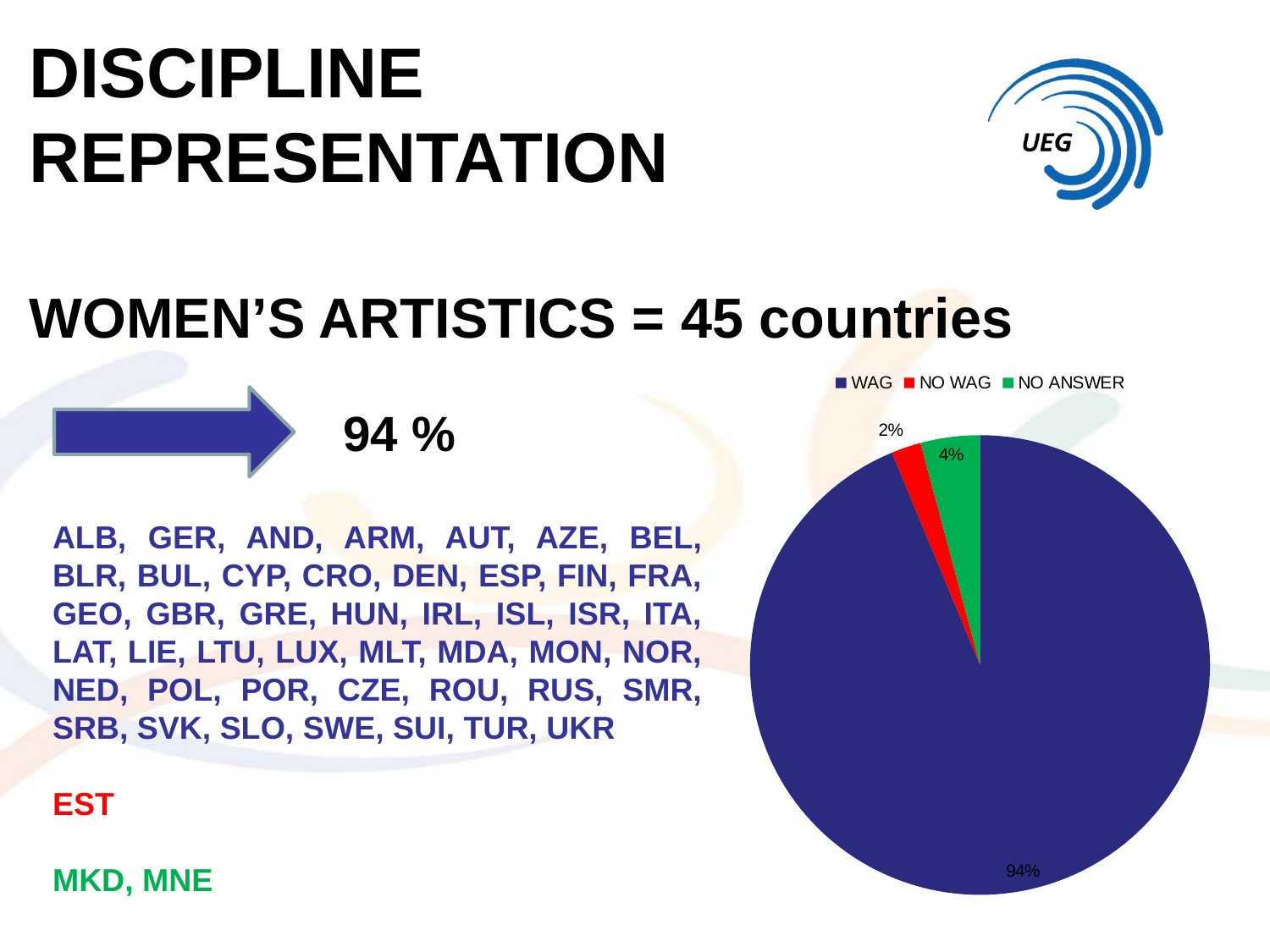
What share of the pie does NO ANSWER represent? 4% Which category has the largest slice of the pie? WAG Which is larger, the NO ANSWER slice or the NO WAG slice? NO ANSWER What colour is the WAG slice in the pie chart? dark blue What kind of chart is shown on the slide? pie chart What share of the pie does NO WAG represent? 2% Which category has the smallest slice of the pie? NO WAG What share of the pie does WAG represent? 94% What colour is the NO ANSWER slice in the pie chart? green What is the difference in percentage points between the WAG slice and the NO ANSWER slice? 90 How many entries does the legend list? 3 How many slices does the pie chart have? 3